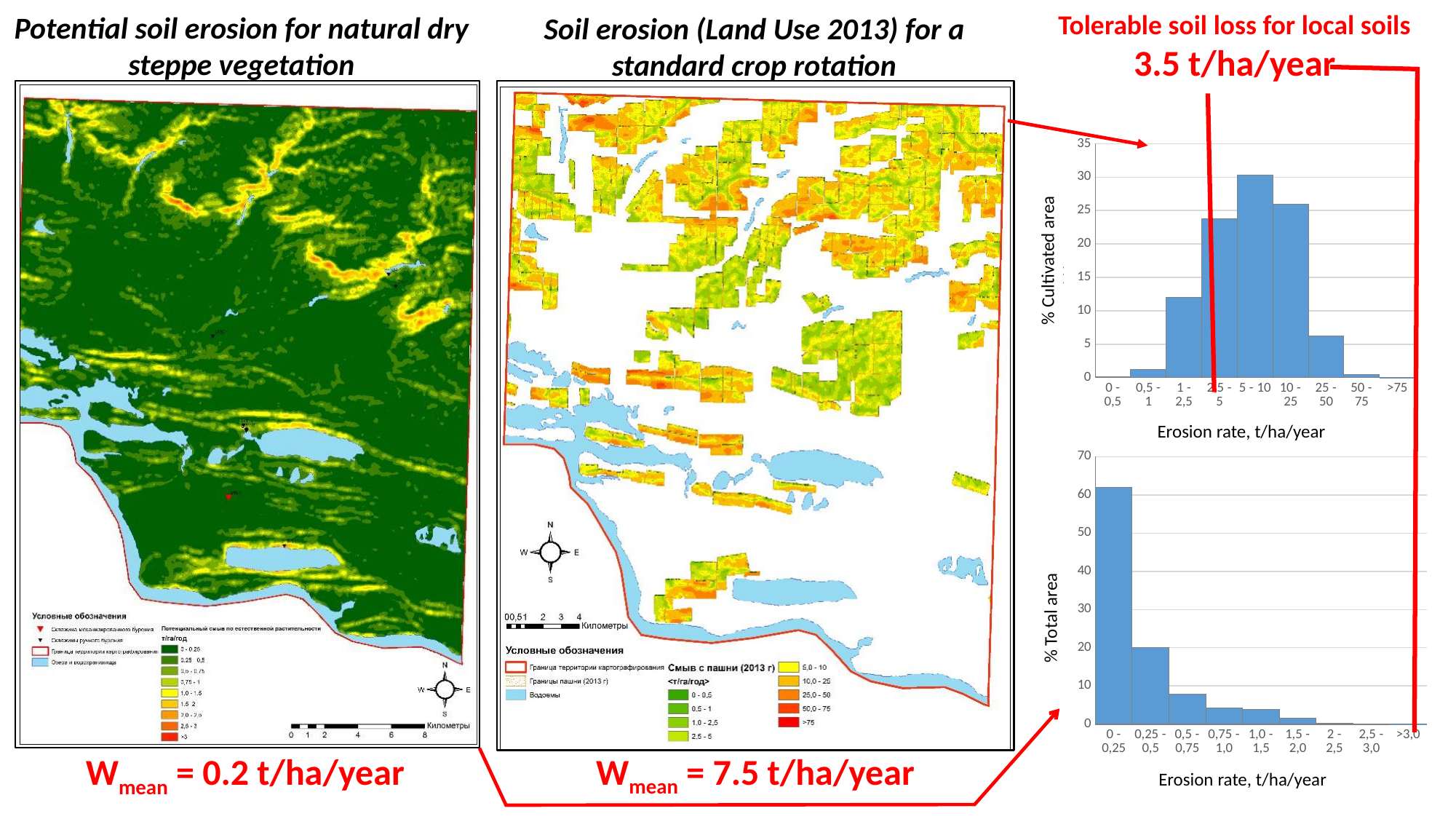
In the bottom chart (% Total area), do the values rise or fall as the erosion rate increases along the x axis? fall In the top chart (% Cultivated area), is the value for the 25 - 50 category greater or less than 10? less In the top chart (% Cultivated area), which is larger, the value for 5 - 10 or the value for 25 - 50? 5 - 10 In the top chart (% Cultivated area), is the value for the 5 - 10 category greater or less than 25? greater In the bottom chart (% Total area), is the value for the 0 - 0,25 category greater or less than 50? greater How many erosion rate categories are shown on the x axis of the top chart (% Cultivated area)? 9 What is the x-axis title of the bottom chart (% Total area)? Erosion rate, t/ha/year In the top chart (% Cultivated area), which erosion rate category has the highest share? 5 - 10 What kind of chart is the bottom chart (% Total area)? bar chart In the bottom chart (% Total area), which erosion rate category has the highest share? 0 - 0,25